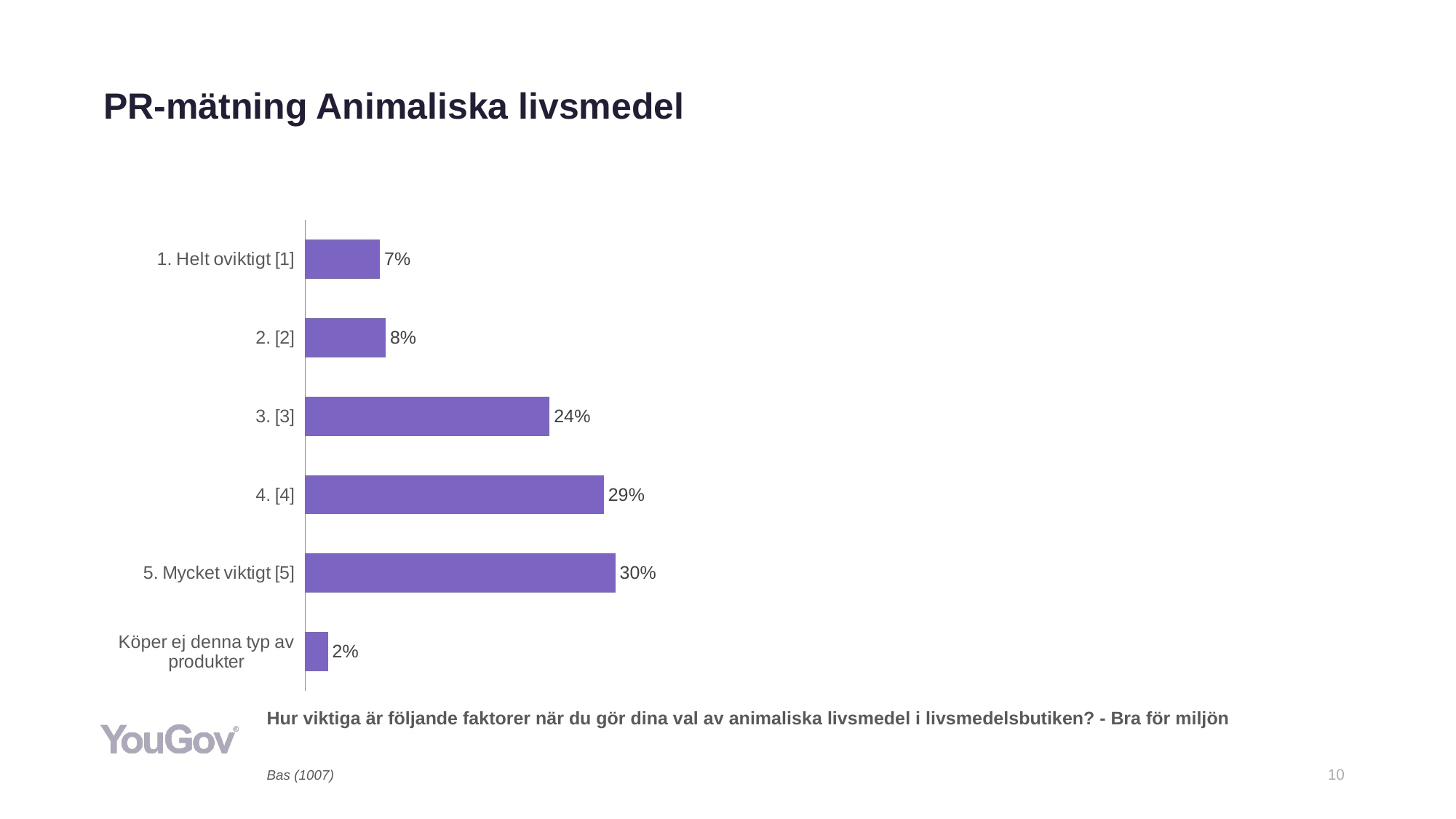
Which is larger, the value for "2. [2]" or the value for "3. [3]"? 3. [3] What kind of chart is shown on the slide? Bar chart Which category has the highest value? 5. Mycket viktigt [5] What is the base (Bas) size stated on the slide? 1007 What percentage of respondents answered "1. Helt oviktigt [1]"? 7% Which category has the lowest value? Köper ej denna typ av produkter How many categories are shown in the chart? 6 What is the difference between the values for "5. Mycket viktigt [5]" and "1. Helt oviktigt [1]"? 23% What is the difference between the values for "4. [4]" and "3. [3]"? 5% What is the value shown for "3. [3]"? 24% What percentage is shown for "Köper ej denna typ av produkter"? 2% What is the combined value of "4. [4]" and "5. Mycket viktigt [5]"? 59%